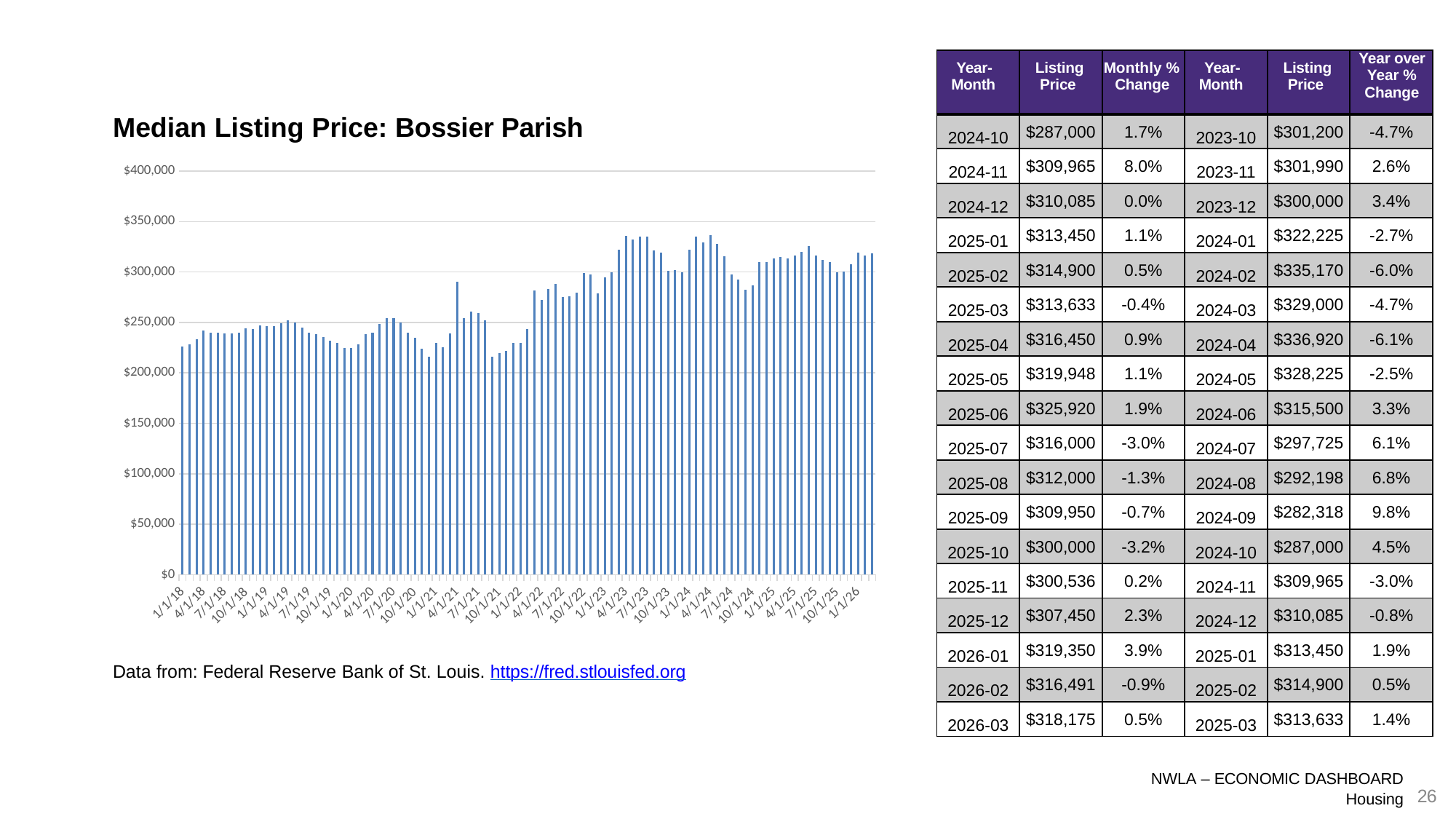
What is the title of the chart? Median Listing Price: Bossier Parish Is the value for 1/1/21 in the chart greater or less than $250,000? less Is the value for 4/1/24 in the chart greater or less than $300,000? greater Overall, do the median listing prices rise or fall from 1/1/18 to 1/1/26 along the x axis? rise What kind of chart is shown on the slide? bar chart According to the table, what was the median listing price for 2025-06? $325,920 Is the value for 7/1/23 in the chart greater or less than $300,000? greater According to the table, what was the monthly % change for 2024-11? 8.0% According to the table, what is the difference between the listing price for 2026-03 and for 2025-03? $4,542 According to the table, what was the year over year % change for 2024-09? 9.8% According to the table, which is larger: the listing price for 2024-04 or for 2024-10? 2024-04